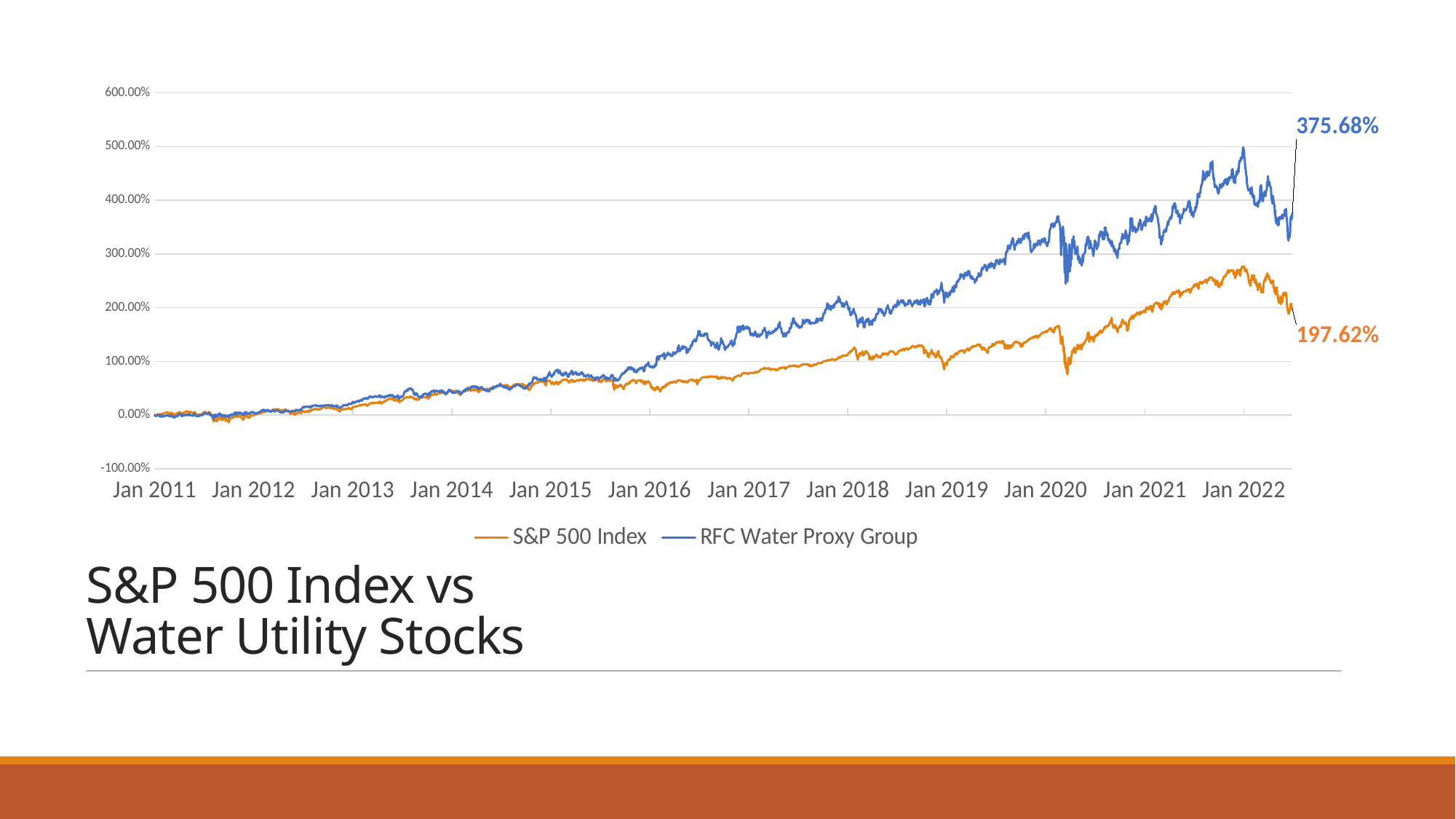
Do the values of the RFC Water Proxy Group series generally rise or fall from Jan 2011 to Jan 2022? Rise Is the value of the RFC Water Proxy Group at Jan 2019 greater or less than 100.00%? greater What kind of chart is shown on the slide? Line chart Which series reaches the highest value anywhere on the chart? RFC Water Proxy Group How many series does the legend list? 2 Is the value of the S&P 500 Index at Jan 2018 greater or less than 200.00%? less What colour is the line for the S&P 500 Index? Orange What is the final labelled value for the RFC Water Proxy Group series? 375.68% How many year labels are shown on the x axis? 12 What is the difference between the final labelled values of the RFC Water Proxy Group and the S&P 500 Index? 178.06% Which series ends at a higher value, the S&P 500 Index or the RFC Water Proxy Group? RFC Water Proxy Group What is the final labelled value for the S&P 500 Index series? 197.62%